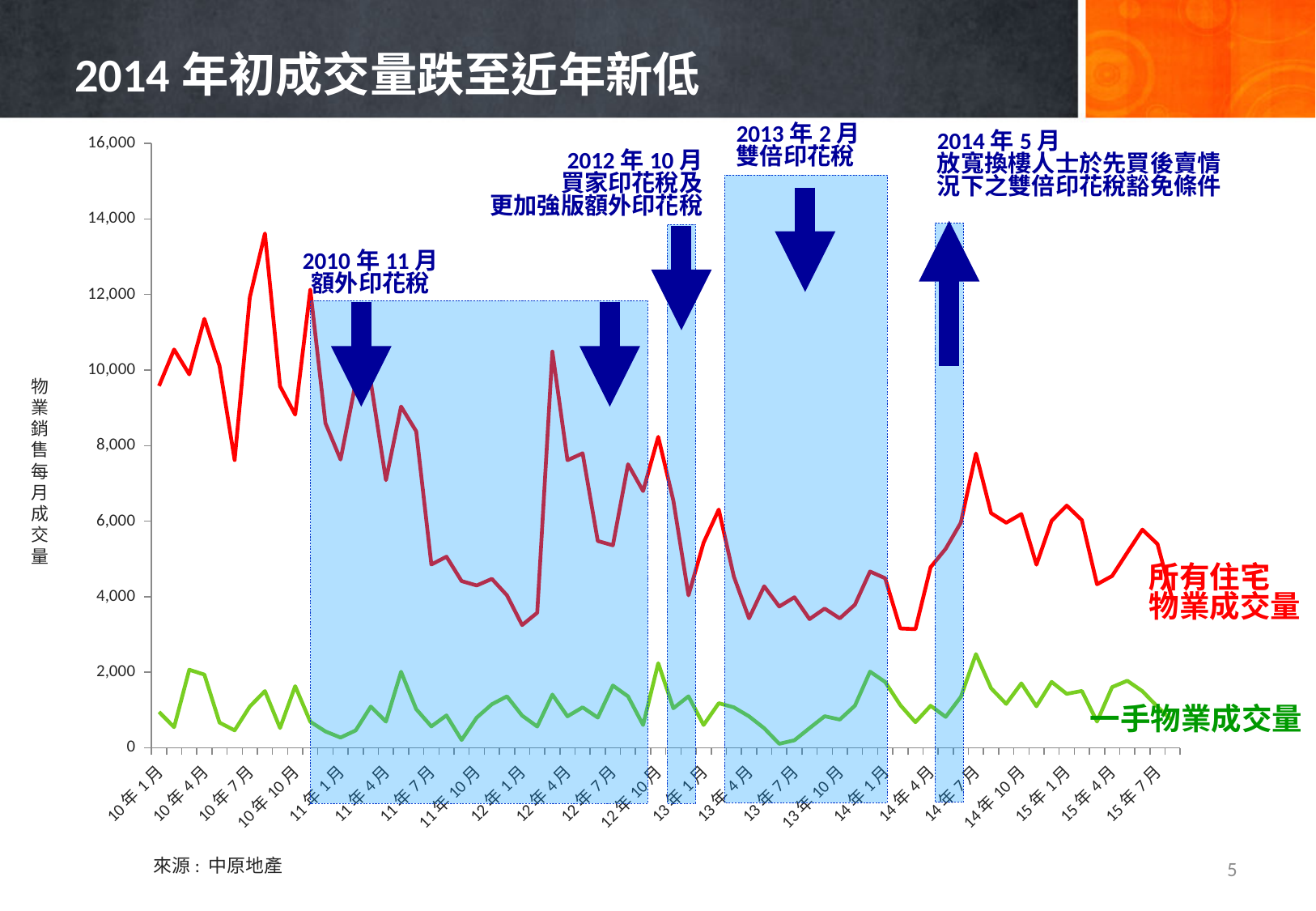
Does the 所有住宅物業成交量 line generally rise or fall from 14年7月 to 15年7月? fall How many data series are plotted on the chart? 2 Is the value of 一手物業成交量 at 13年7月 greater or less than 1,000? less Which series reaches the highest value on the chart? 所有住宅物業成交量 What is the highest value shown on the vertical axis? 16,000 At 12年4月, which series has the larger value, 所有住宅物業成交量 or 一手物業成交量? 所有住宅物業成交量 What is the title of the slide? 2014 年初成交量跌至近年新低 Is the value of 一手物業成交量 at 14年7月 greater or less than 2,000? greater Is the value of 所有住宅物業成交量 at 10年1月 greater or less than 8,000? greater What kind of chart is shown on the slide? line chart